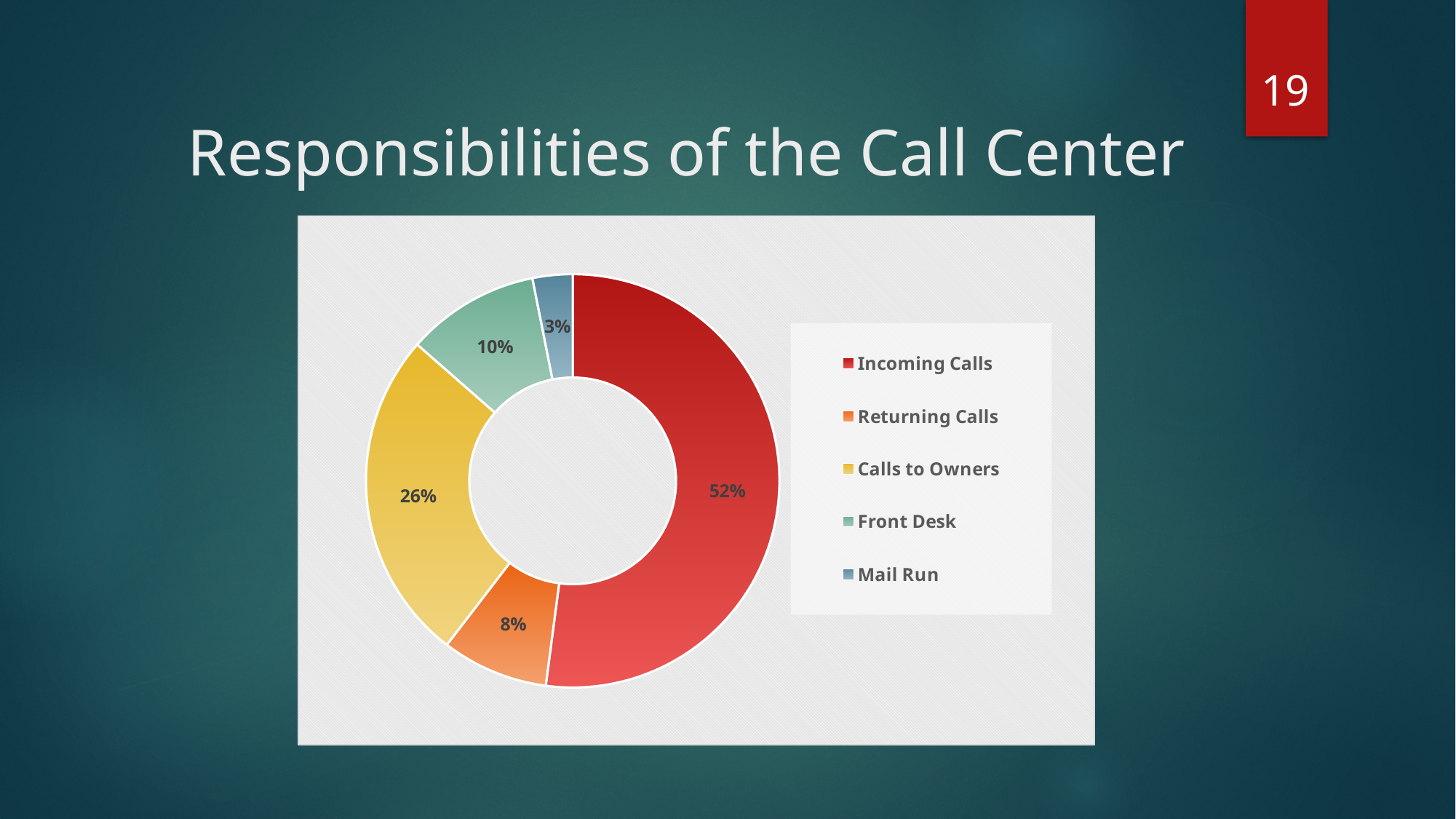
What share of the chart is Incoming Calls? 52% What share of the chart is Returning Calls? 8% What is the difference in percentage points between Incoming Calls and Calls to Owners? 26 How many categories does the chart show? 5 Which category has the smallest share? Mail Run What colour represents Calls to Owners in the chart? Yellow What kind of chart is shown on the slide? Doughnut chart Which category has the largest share? Incoming Calls What share of the chart is Mail Run? 3% Which is larger, Front Desk or Returning Calls? Front Desk